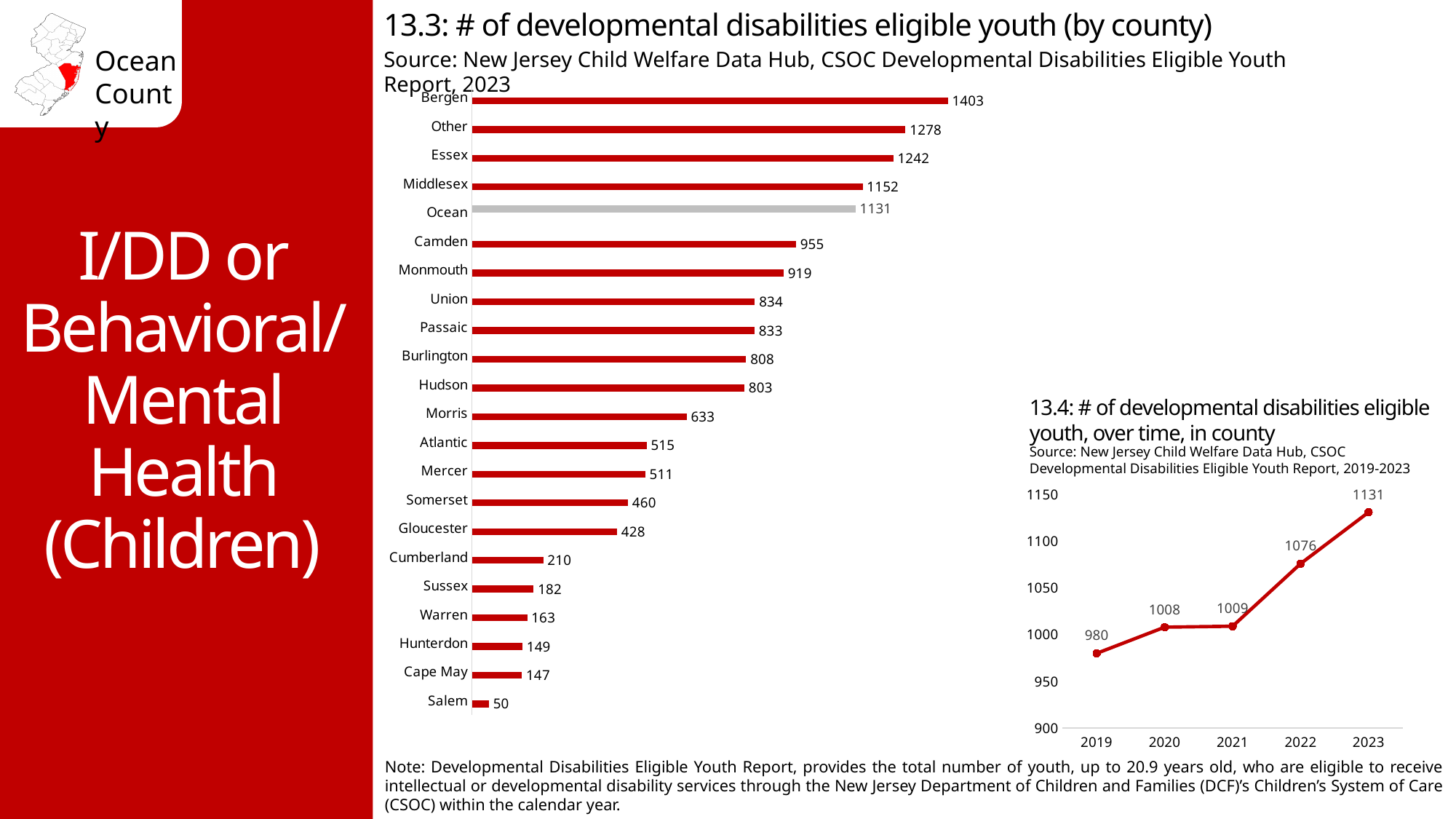
In chart 13.3 (by county), which has a larger value, Camden or Monmouth? Camden In chart 13.3 (by county), what is the difference between the values for Bergen and Essex? 161 In chart 13.3 (by county), which county has the lowest number of developmental disabilities eligible youth? Salem In chart 13.3 (# of developmental disabilities eligible youth by county), what is the value for Ocean? 1131 In chart 13.4 (over time, in county), what is the difference between the 2023 and 2019 values? 151 In chart 13.4 (over time, in county), what is the value for 2021? 1009 How many data points are plotted in chart 13.4 (over time, in county)? 5 What kind of chart is chart 13.3 (# of developmental disabilities eligible youth by county)? Bar chart In chart 13.3 (by county), which county has the highest number of developmental disabilities eligible youth? Bergen How many counties/categories are shown in chart 13.3 (by county)? 22 In chart 13.4 (over time, in county), do the values rise or fall from 2019 to 2023? Rise In chart 13.3 (by county), what is the value for Cumberland? 210